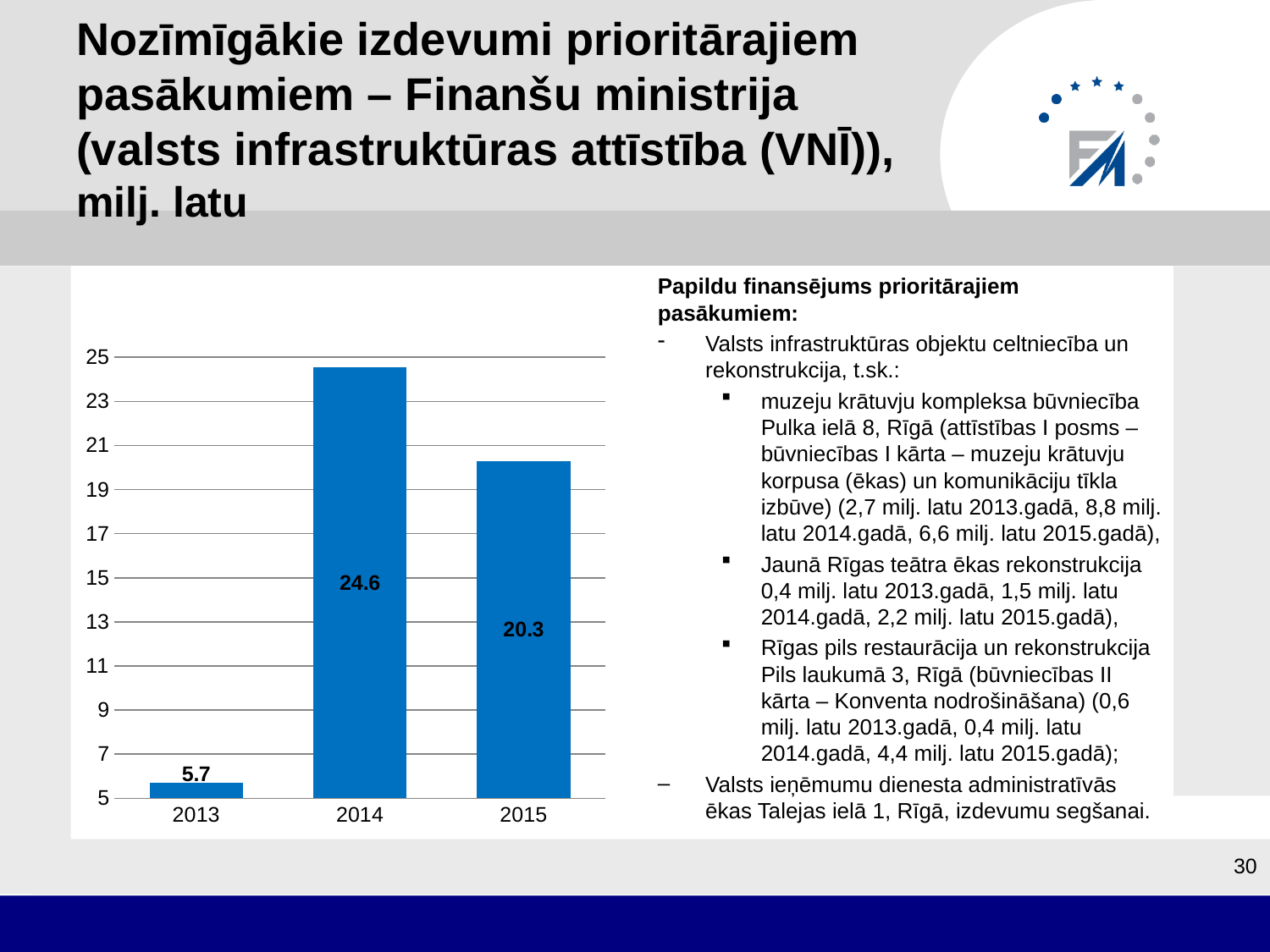
What is the difference between the values for 2014 and 2015? 4.3 Which year has the lowest value? 2013 How many years are shown on the x axis? 3 What is the value for 2013? 5.7 Is the value for 2015 greater or less than 21? less What is the difference between the values for 2014 and 2013? 18.9 What is the total of the values for 2013, 2014 and 2015? 50.6 What is the value for 2015? 20.3 Which is larger, the value for 2015 or the value for 2013? 2015 What is the value for 2014? 24.6 Which year has the highest value? 2014 What kind of chart is shown on the slide? bar chart